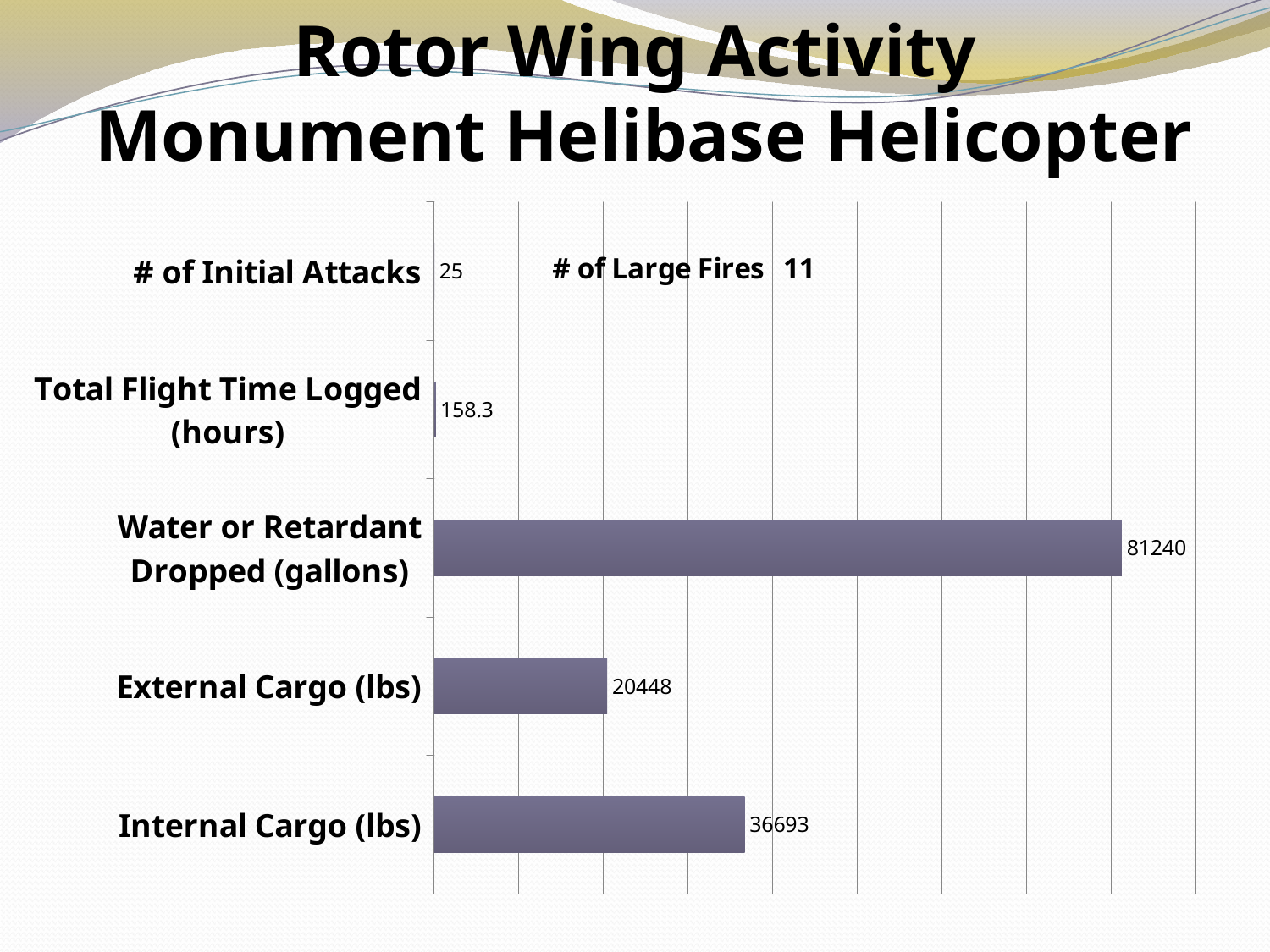
What is the value for Internal Cargo (lbs)? 36693 What kind of chart is shown on the slide? Bar chart Which is larger, Internal Cargo (lbs) or External Cargo (lbs)? Internal Cargo (lbs) What is the title of the slide containing the chart? Rotor Wing Activity Monument Helibase Helicopter What is the value for External Cargo (lbs)? 20448 How many categories are shown on the chart's axis? 5 What is the value for Total Flight Time Logged (hours)? 158.3 Which category has the lowest value? # of Initial Attacks What is the difference between Internal Cargo (lbs) and External Cargo (lbs)? 16245 Which category has the highest value? Water or Retardant Dropped (gallons) What is the value for Water or Retardant Dropped (gallons)? 81240 What is the value for # of Initial Attacks? 25